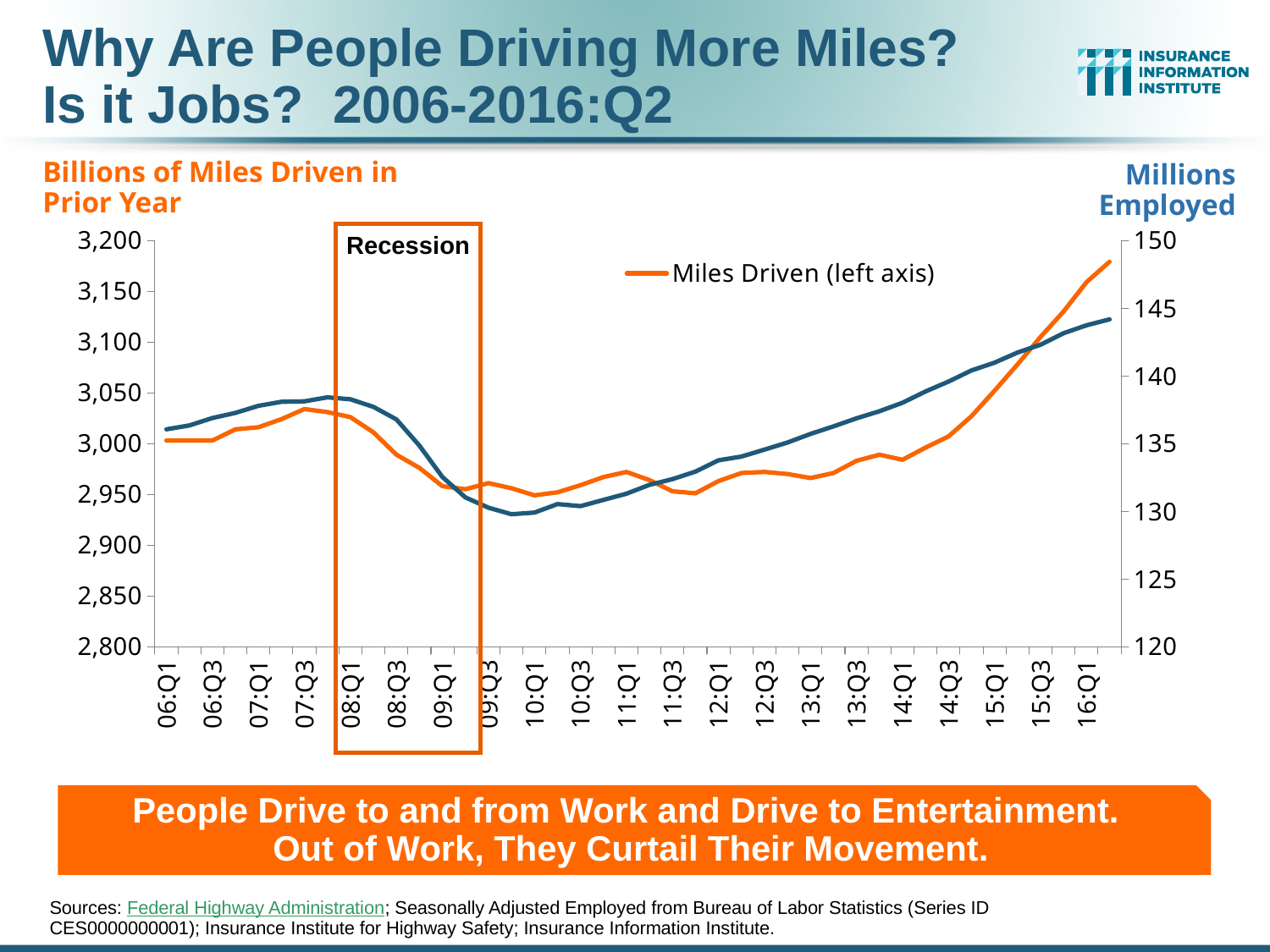
Is the value of the Millions Employed series (right axis) at 10:Q1 greater or less than 135? less Does the Miles Driven line rise or fall between 14:Q1 and 16:Q1? rise How many quarter labels are shown on the x axis? 21 Is the value for Miles Driven at 06:Q1 greater or less than 3,050? less Which is larger for Miles Driven: the value at 07:Q3 or the value at 09:Q1? 07:Q3 What is the title of the right-hand axis? Millions Employed What is the legend entry shown on the chart? Miles Driven (left axis) Is the value of the Millions Employed series (right axis) at 16:Q1 greater or less than 140? greater How many series does the chart legend list? 1 What type of chart is shown on the slide? line chart